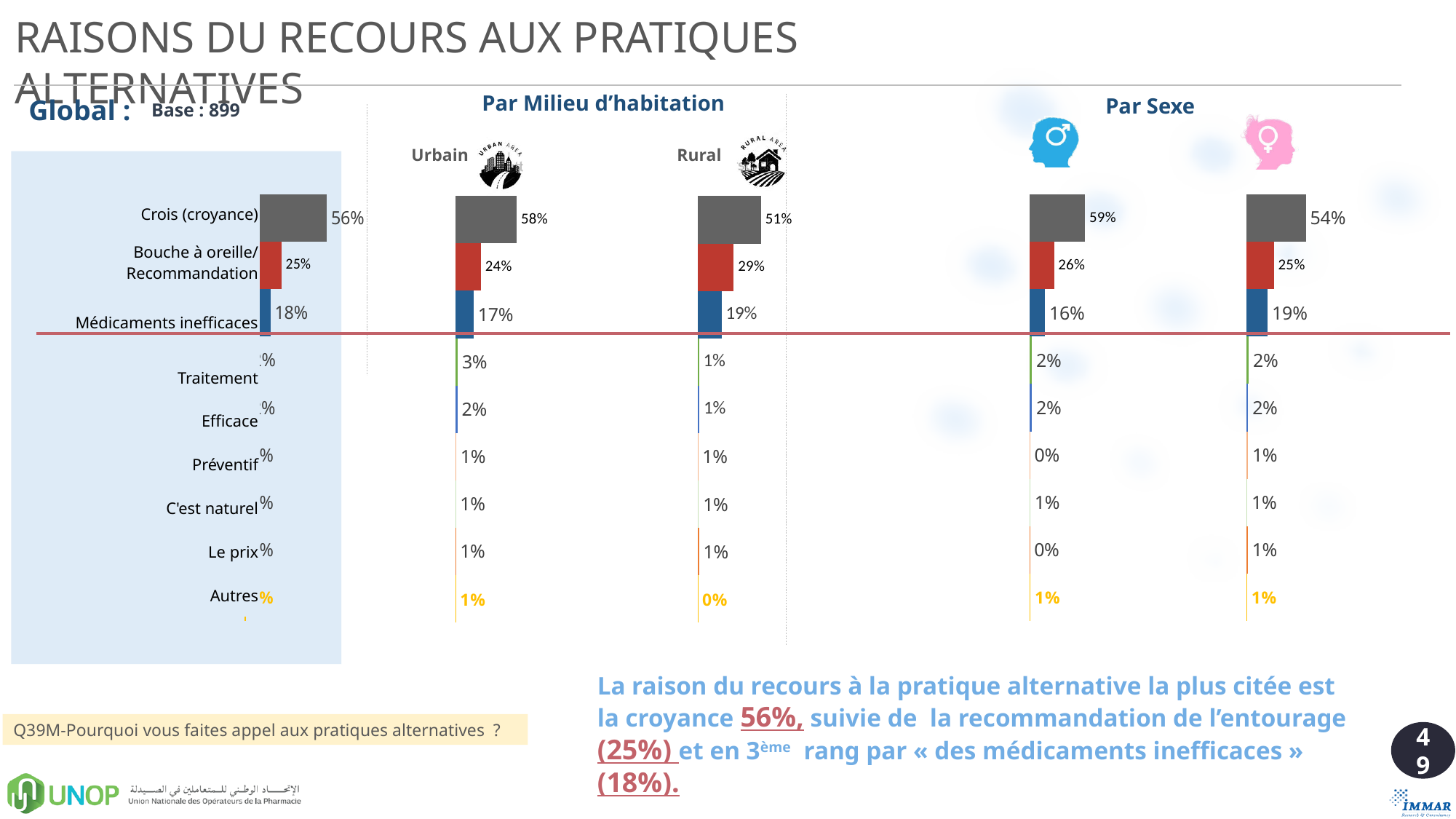
Which is larger: the Urbain value for Traitement or the Rural value for Traitement? Urbain In the male (Par Sexe) chart, what is the value for Crois (croyance)? 59% In the Global chart, what is the value for Crois (croyance)? 56% In the Global chart, which category has the highest value? Crois (croyance) What is the difference between the Urbain and Rural values for Crois (croyance)? 7% In the Urbain chart, what is the value for Crois (croyance)? 58% What type of chart is used to show the reasons in the Global section? Bar chart In the Global chart, what is the value for Bouche à oreille/Recommandation? 25% In the Rural chart, what is the value for Autres? 0% In the female (Par Sexe) chart, what is the value for Médicaments inefficaces? 19% In the Rural chart, what is the value for Bouche à oreille/Recommandation? 29% In the Global chart, what is the value for Médicaments inefficaces? 18%